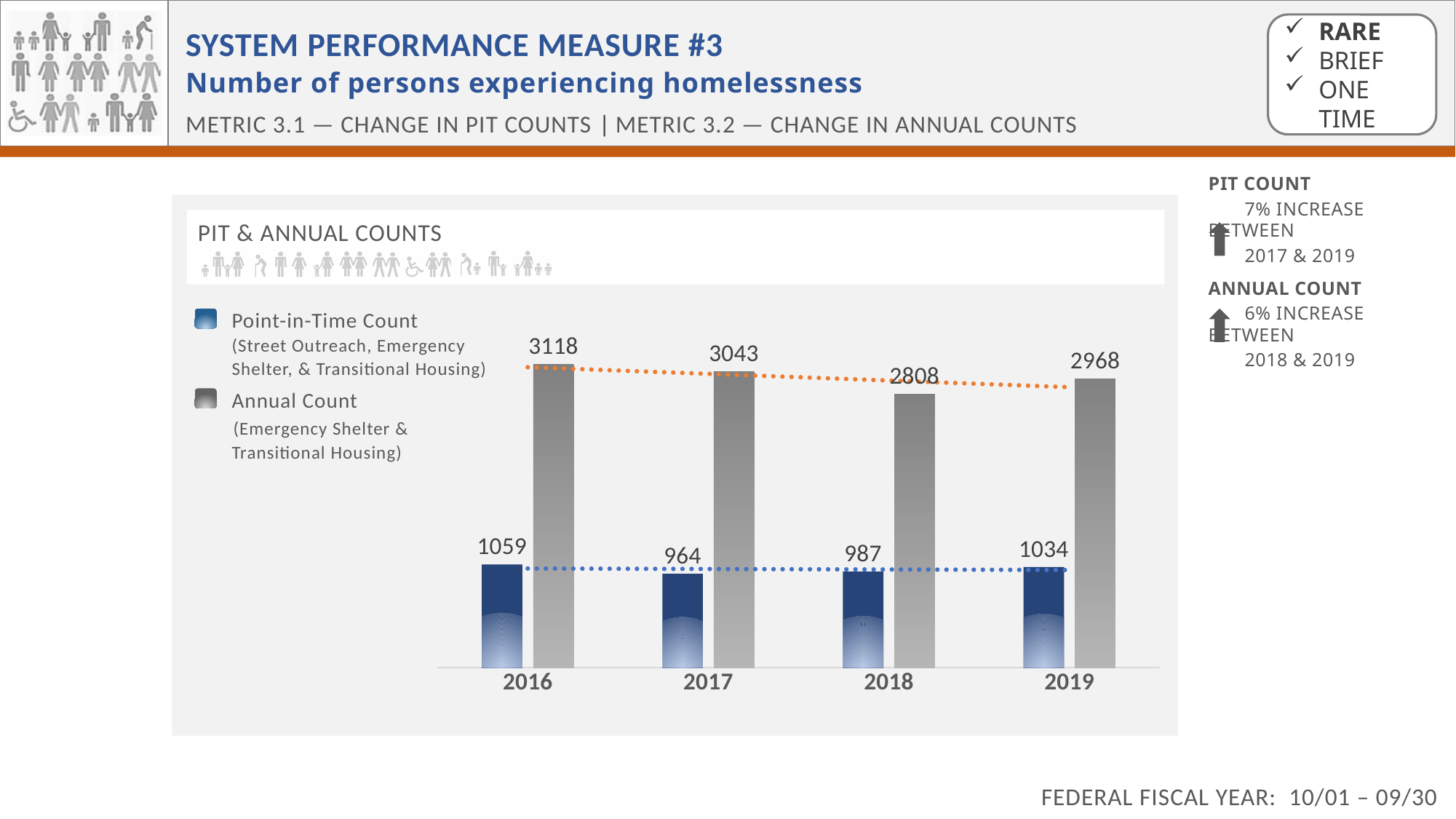
Which year had the highest Annual Count? 2016 Which is larger, the Annual Count in 2017 or the Annual Count in 2019? Annual Count in 2017 How many years are shown on the x axis of the chart? 4 What was the Annual Count in 2018? 2808 What kind of chart is used to show the PIT & Annual Counts? Bar chart What is the difference between the Annual Count in 2016 and the Annual Count in 2018? 310 Which year had the lowest Point-in-Time Count? 2017 What was the Point-in-Time Count in 2016? 1059 What is the title of the chart? PIT & ANNUAL COUNTS What is the difference between the Point-in-Time Count in 2019 and the Point-in-Time Count in 2017? 70 How many series does the chart's legend list? 2 What was the Annual Count in 2019? 2968